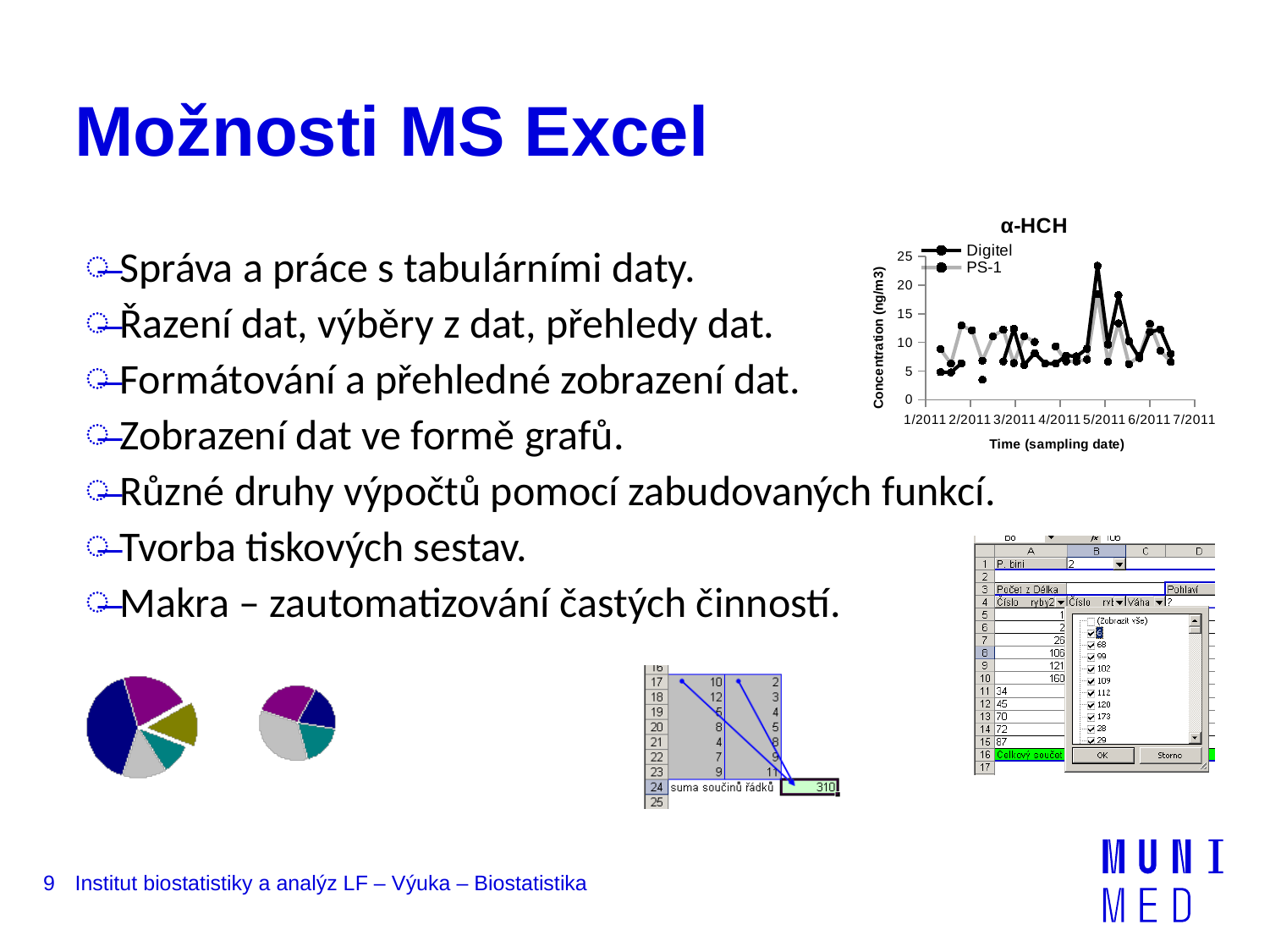
How many series does the legend of the α-HCH chart list? 2 What are the names of the two series in the α-HCH chart? Digitel and PS-1 In the α-HCH chart, is the peak value of the Digitel series around 5/2011 greater or less than 20? greater What is the first date tick on the x-axis of the α-HCH chart? 1/2011 What is the highest tick value shown on the y-axis of the α-HCH chart? 25 What kind of chart is the α-HCH chart? line chart What is the x-axis label of the α-HCH chart? Time (sampling date) What is the y-axis label of the α-HCH chart? Concentration (ng/m3) What is the last date tick on the x-axis of the α-HCH chart? 7/2011 How many date ticks are shown on the x-axis of the α-HCH chart? 7 What kind of charts are the two small charts at the bottom left of the slide? pie charts What is the title of the line chart on the slide? α-HCH